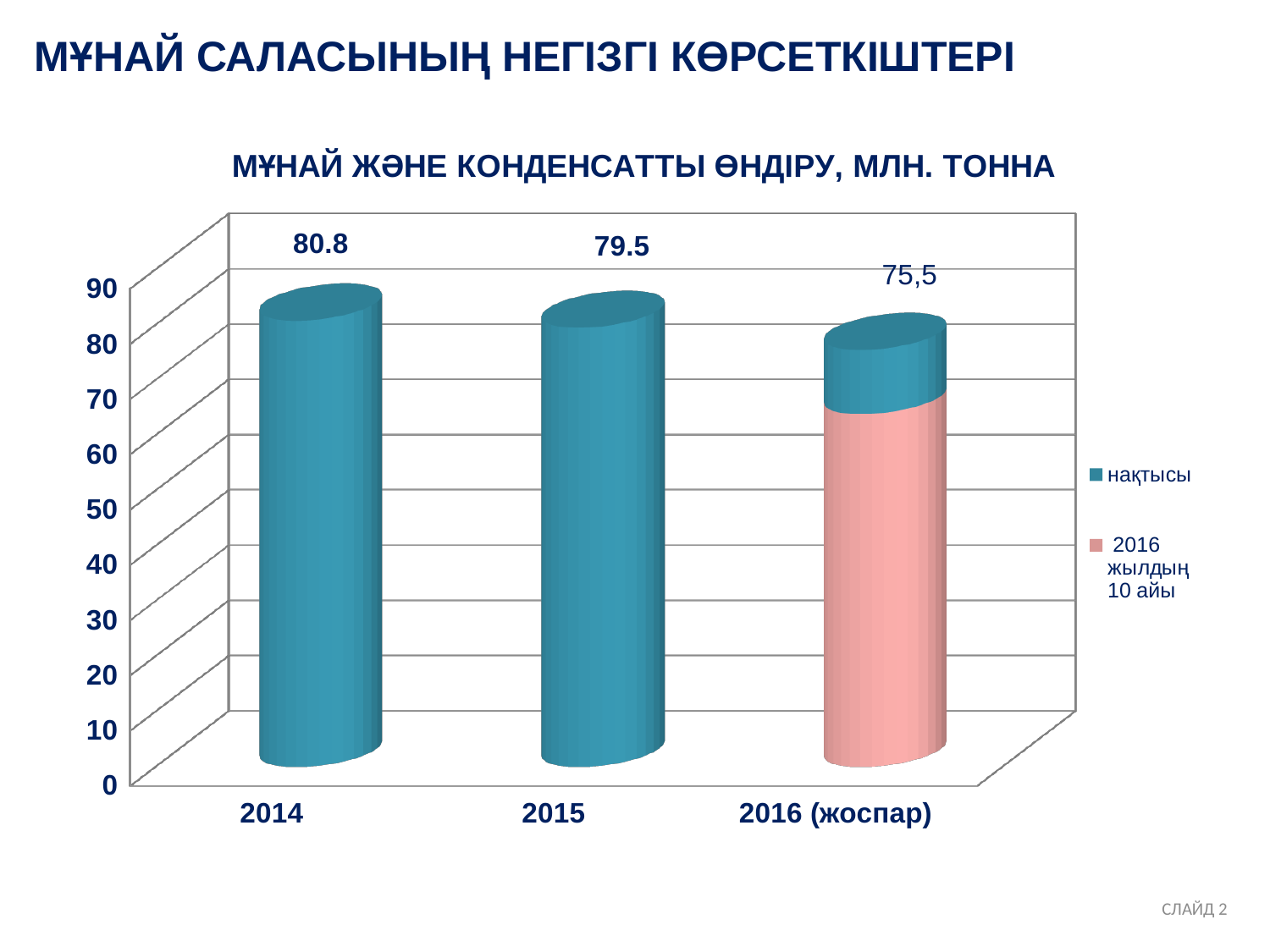
What is the title of the chart? МҰНАЙ ЖӘНЕ КОНДЕНСАТТЫ ӨНДІРУ, МЛН. ТОННА What value is labelled above the 2016 (жоспар) bar? 75,5 What is the difference between the values for 2014 and 2015? 1.3 Which category has the lowest value? 2016 (жоспар) How many categories are shown on the x axis? 3 Which is larger, the value for 2014 or the value for 2015? 2014 What is the value for 2015? 79.5 Which year has the highest value? 2014 What is the value for 2014? 80.8 What kind of chart is shown on the slide? Bar chart Do the values rise or fall from 2014 to 2016 (жоспар)? Fall How many series does the legend list? 2